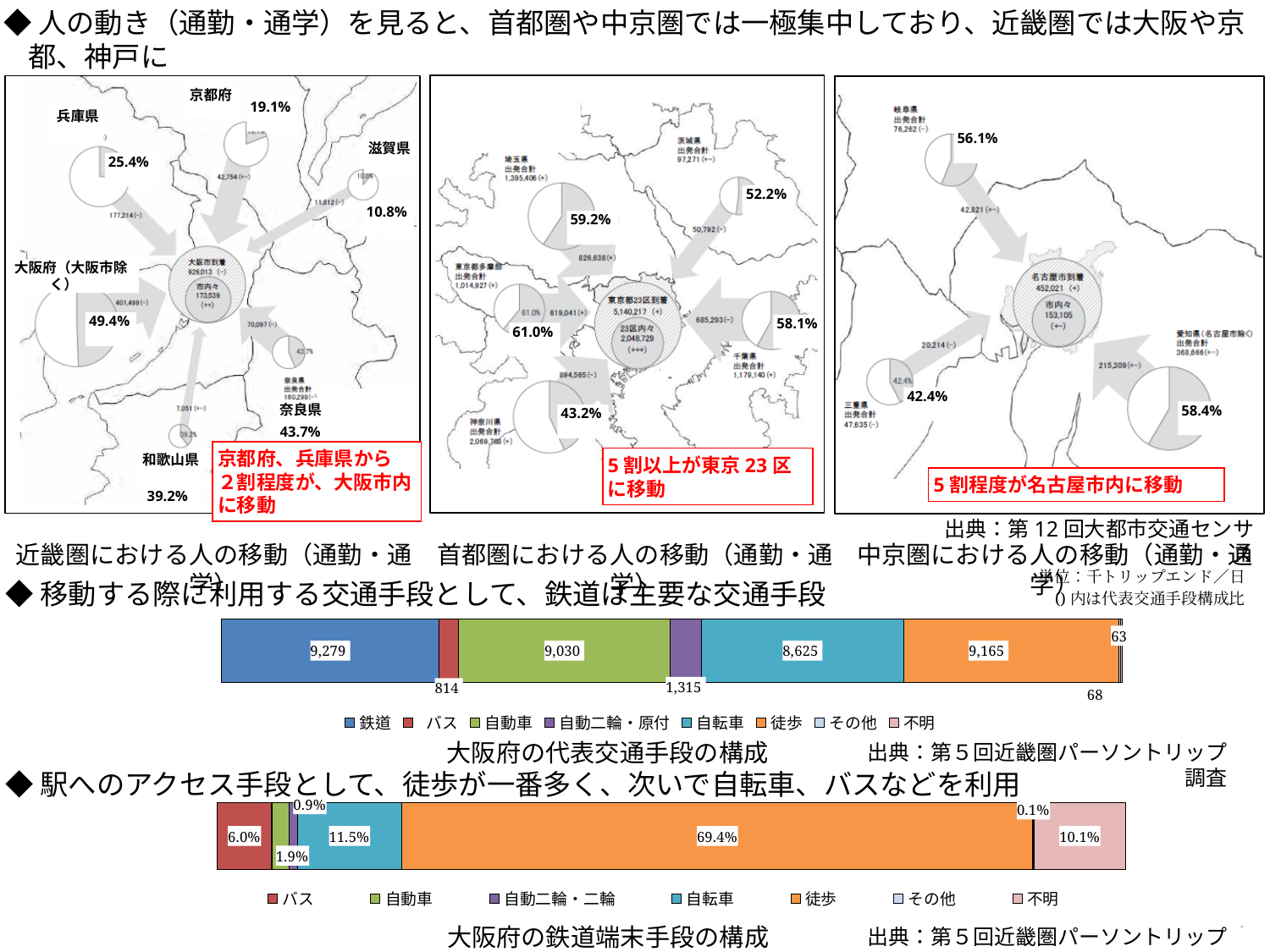
In the chart titled 大阪府の鉄道端末手段の構成, which mode has the smallest share? その他 In the chart titled 大阪府の代表交通手段の構成, how many series does the legend list? 8 In the chart titled 大阪府の鉄道端末手段の構成, what is the share for 自転車? 11.5% In the chart titled 大阪府の鉄道端末手段の構成, what is the share for 徒歩? 69.4% In the chart titled 大阪府の代表交通手段の構成, which is larger, バス or 自動二輪・原付? 自動二輪・原付 In the chart titled 大阪府の代表交通手段の構成, what is the difference between 鉄道 and 徒歩? 114 In the chart titled 大阪府の代表交通手段の構成, what is the value for 鉄道? 9,279 In the chart titled 大阪府の代表交通手段の構成, which mode has the highest value? 鉄道 In the chart titled 大阪府の鉄道端末手段の構成, how many series does the legend list? 7 In the chart titled 大阪府の代表交通手段の構成, what is the value for 自転車? 8,625 In the chart titled 大阪府の鉄道端末手段の構成, what is the difference between 不明 and バス? 4.1% What kind of chart is 大阪府の代表交通手段の構成? Stacked bar chart